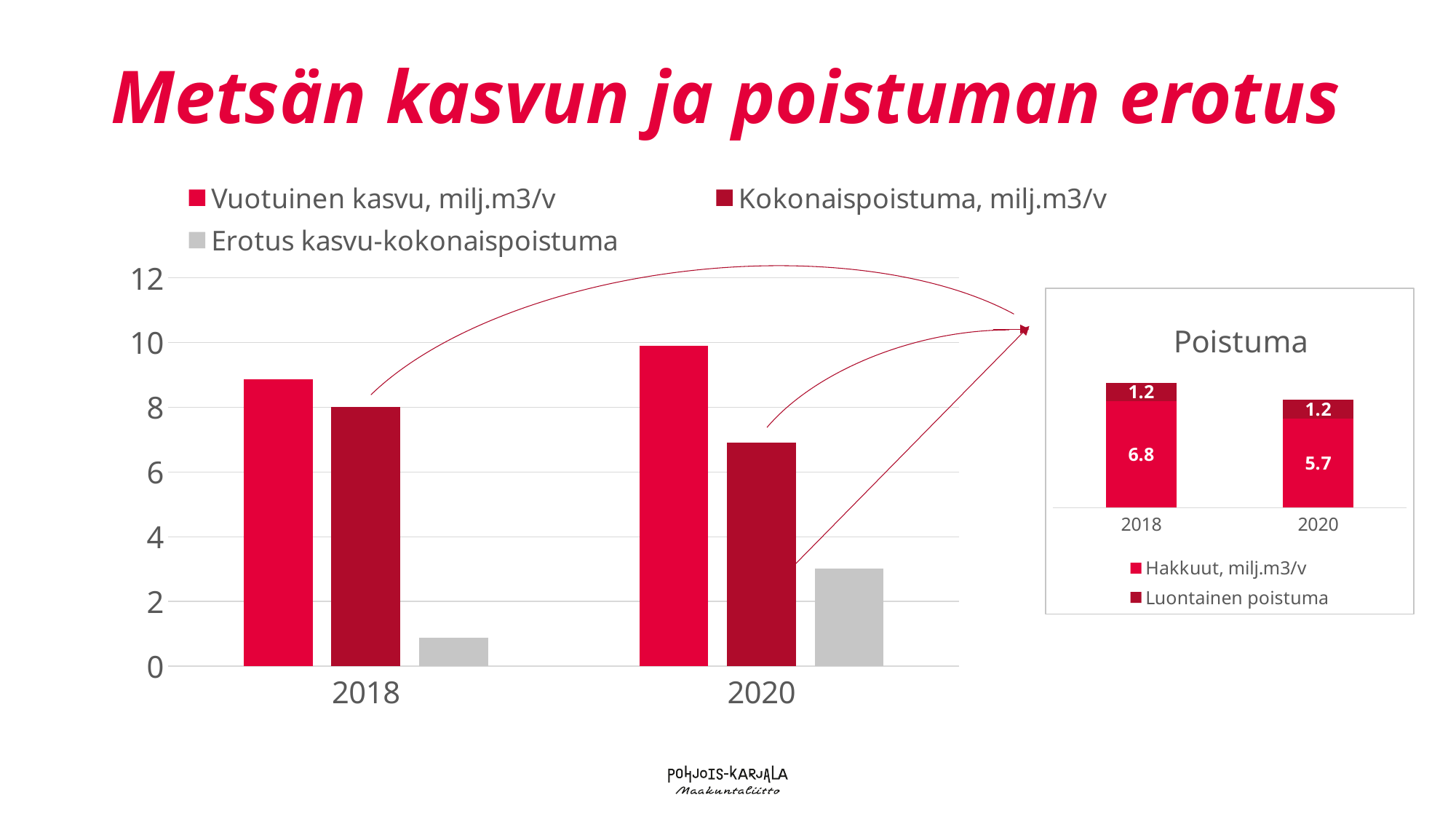
In the main chart, does Kokonaispoistuma rise or fall from 2018 to 2020? fall In the Poistuma chart, what is the total of the stacked bar for 2018? 8.0 In the main chart, what kind of chart is shown? bar chart In the Poistuma chart, what is the value for Hakkuut in 2018? 6.8 In the main chart, is the value for Vuotuinen kasvu in 2020 greater or less than 8? greater In the main chart, is the value for Erotus kasvu-kokonaispoistuma in 2018 greater or less than 2? less In the Poistuma chart, what is the difference between Hakkuut in 2018 and Hakkuut in 2020? 1.1 In the main chart, how many series does the legend list? 3 In the main chart, which year has the larger Erotus kasvu-kokonaispoistuma, 2018 or 2020? 2020 In the Poistuma chart, what is the value for Luontainen poistuma in 2020? 1.2 In the main chart, how many years are shown on the x axis? 2 In the Poistuma chart, what is the value for Hakkuut in 2020? 5.7